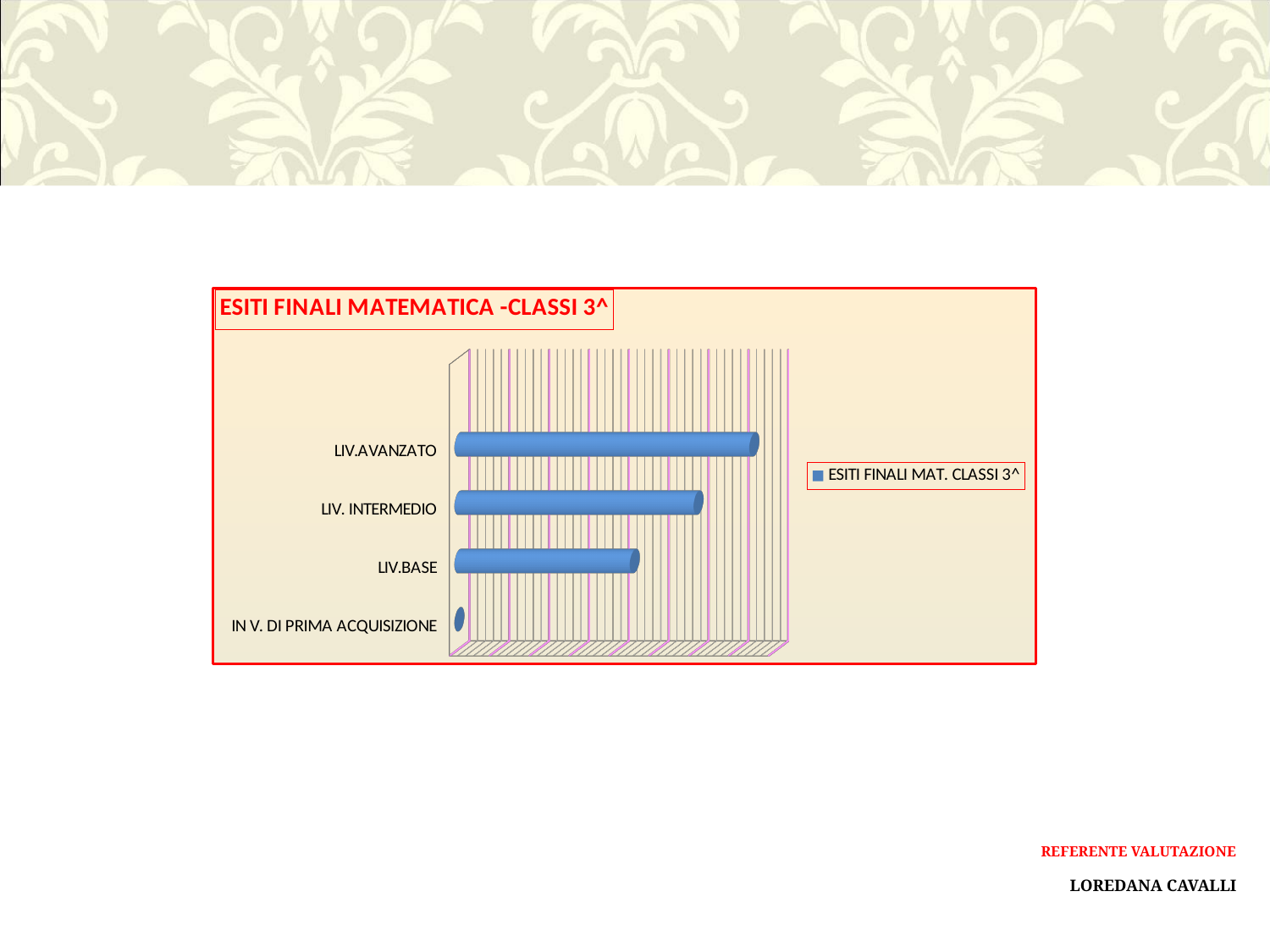
What kind of chart is shown on the slide? Bar chart How many series does the legend list? 1 How many categories are shown in the chart? 4 Which category has the highest value in the chart? LIV.AVANZATO Which category has the lowest value in the chart? IN V. DI PRIMA ACQUISIZIONE Which has the larger value, LIV. INTERMEDIO or LIV.BASE? LIV. INTERMEDIO Which has the larger value, LIV.AVANZATO or LIV. INTERMEDIO? LIV.AVANZATO Which category has the second-highest value in the chart? LIV. INTERMEDIO Which has the larger value, LIV.BASE or IN V. DI PRIMA ACQUISIZIONE? LIV.BASE What is the name of the series shown in the legend? ESITI FINALI MAT. CLASSI 3^ What is the title of the chart? ESITI FINALI MATEMATICA -CLASSI 3^